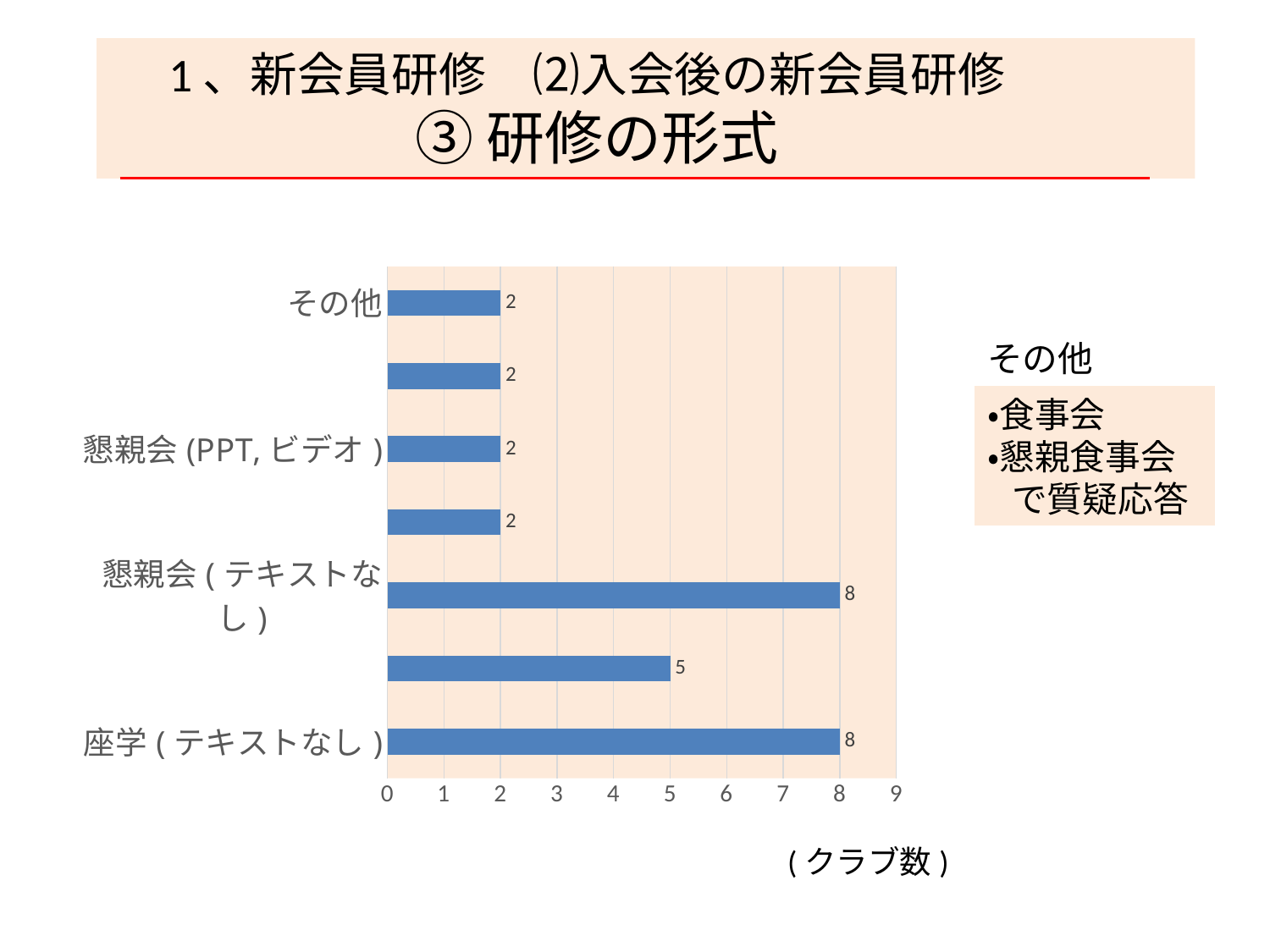
What is the difference between the values for 座学(テキストなし) and 懇親会(PPT, ビデオ)? 6 Which has a larger value, 懇親会(テキストなし) or その他? 懇親会(テキストなし) How many bars are plotted in the chart? 7 Is the value for 座学(テキストなし) greater or less than 5? greater What is the value for 懇親会(テキストなし)? 8 What is the value for 懇親会(PPT, ビデオ)? 2 What is the highest value shown on any bar in the chart? 8 What is the value for その他? 2 What unit is indicated for the horizontal axis of the chart? クラブ数 What is the lowest value shown on any bar in the chart? 2 What is the value for 座学(テキストなし)? 8 What kind of chart is shown on the slide? bar chart